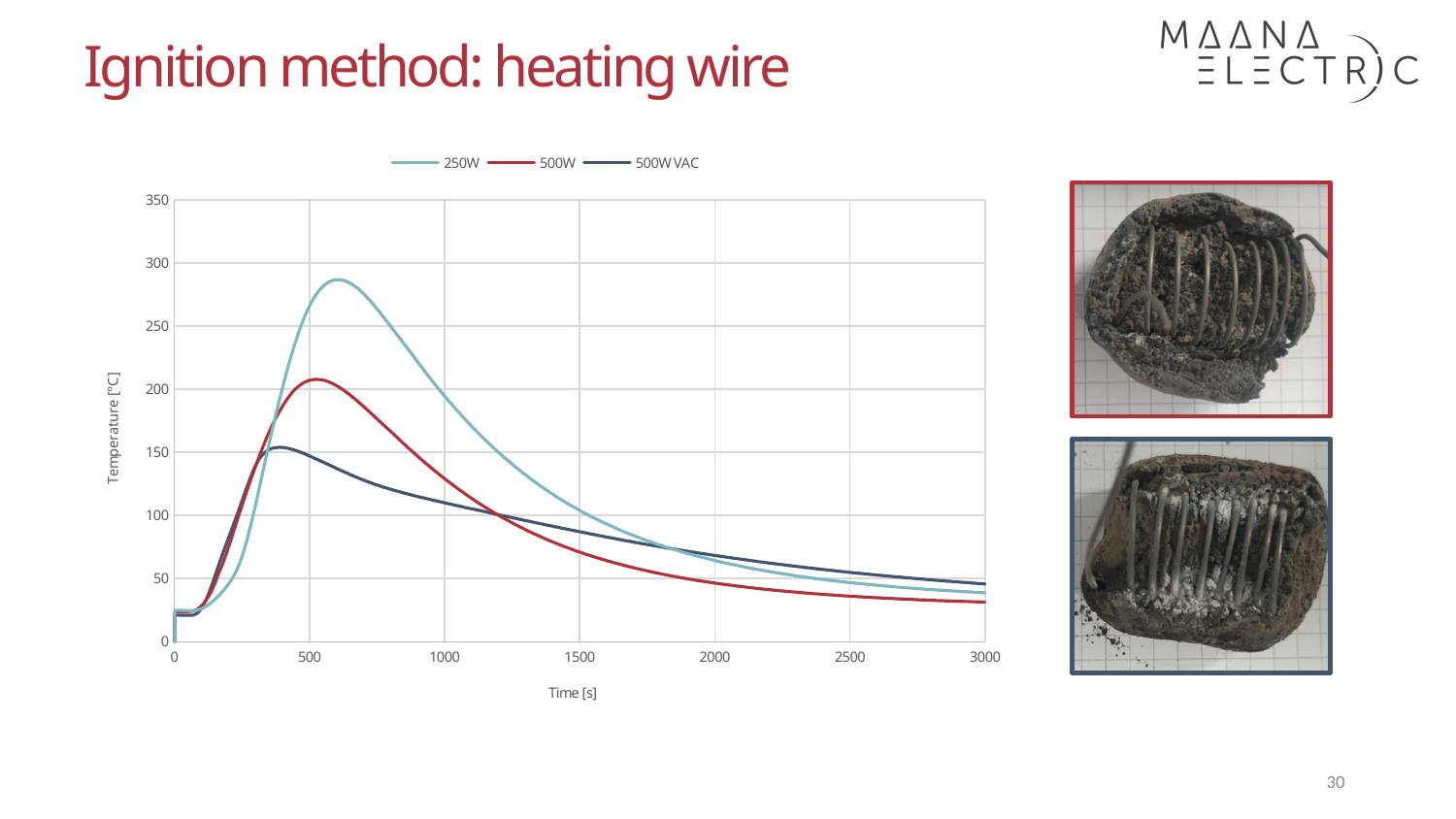
After reaching its peak, does the temperature of the 250W series rise or fall as time increases? fall Is the peak temperature of the 250W series greater or less than 250? greater Is the peak temperature of the 500W VAC series greater or less than 200? less What is the label of the vertical axis of the chart? Temperature [°C] Is the peak temperature of the 500W series greater or less than 250? less Which series reaches the highest peak temperature in the chart? 250W What are the three series named in the chart legend? 250W, 500W, 500W VAC What is the maximum value shown on the Time [s] axis? 3000 Which series has the lowest peak temperature in the chart? 500W VAC What kind of chart is shown on the slide? line chart At 3000 s, which series has the higher temperature, 500W VAC or 500W? 500W VAC How many series does the chart legend list? 3